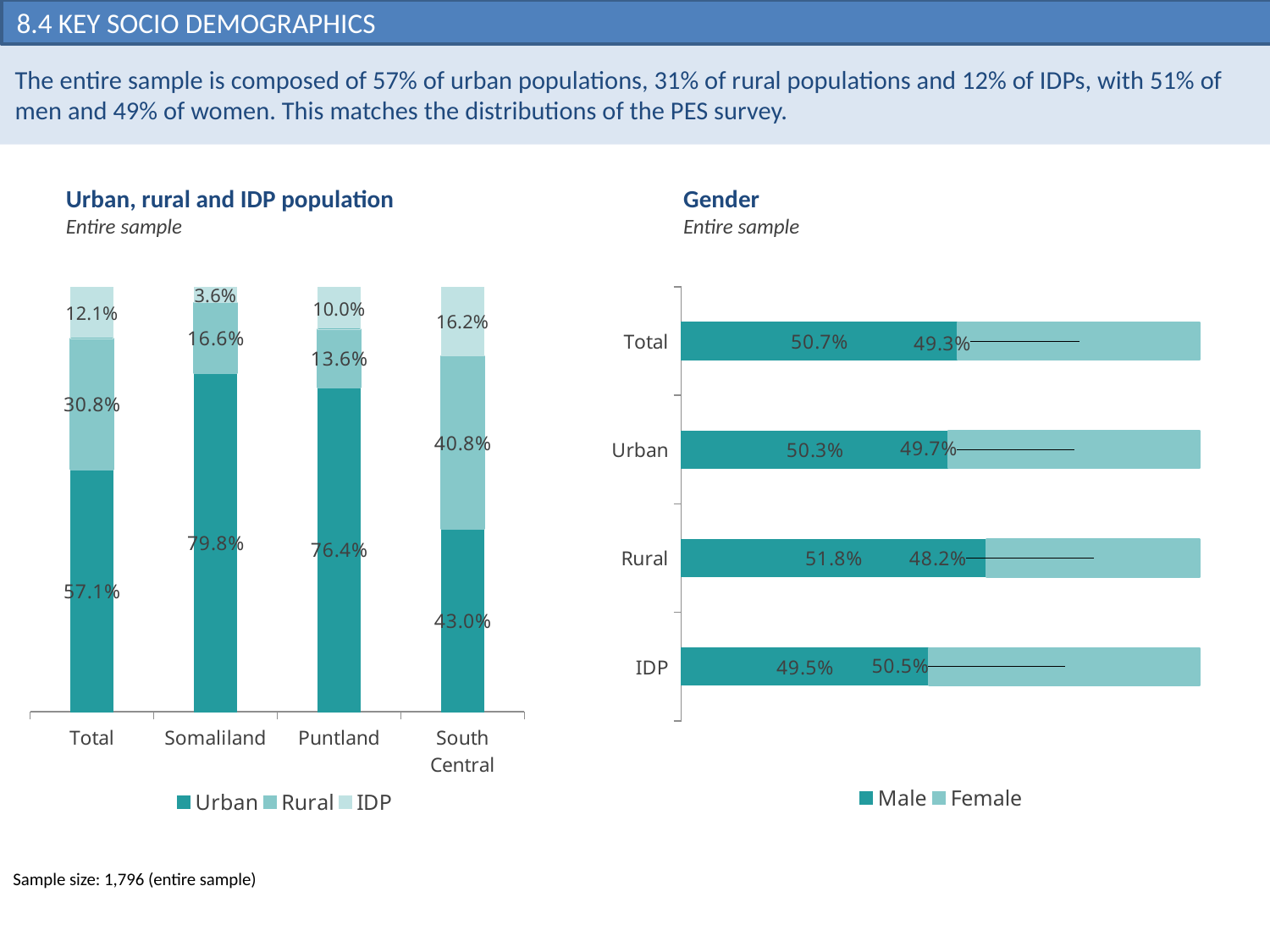
In the 'Urban, rural and IDP population' chart, what is the Urban value for Somaliland? 79.8% In the 'Urban, rural and IDP population' chart, what is the difference between the Urban values for Puntland and South Central? 33.4% In the 'Urban, rural and IDP population' chart, which category has the highest Urban value? Somaliland In the 'Gender' chart, what is the difference between the Male and Female values for Total? 1.4% In the 'Gender' chart, what is the Female value for IDP? 50.5% What kind of chart is the 'Gender' chart? Stacked bar chart In the 'Gender' chart, which category has the highest Male value? Rural In the 'Gender' chart, what is the Male value for Rural? 51.8% In the 'Urban, rural and IDP population' chart, how many categories are shown on the x axis? 4 In the 'Urban, rural and IDP population' chart, what is the IDP value for South Central? 16.2% In the 'Urban, rural and IDP population' chart, how many series does the legend list? 3 In the 'Urban, rural and IDP population' chart, which category has the lowest Rural value? Puntland